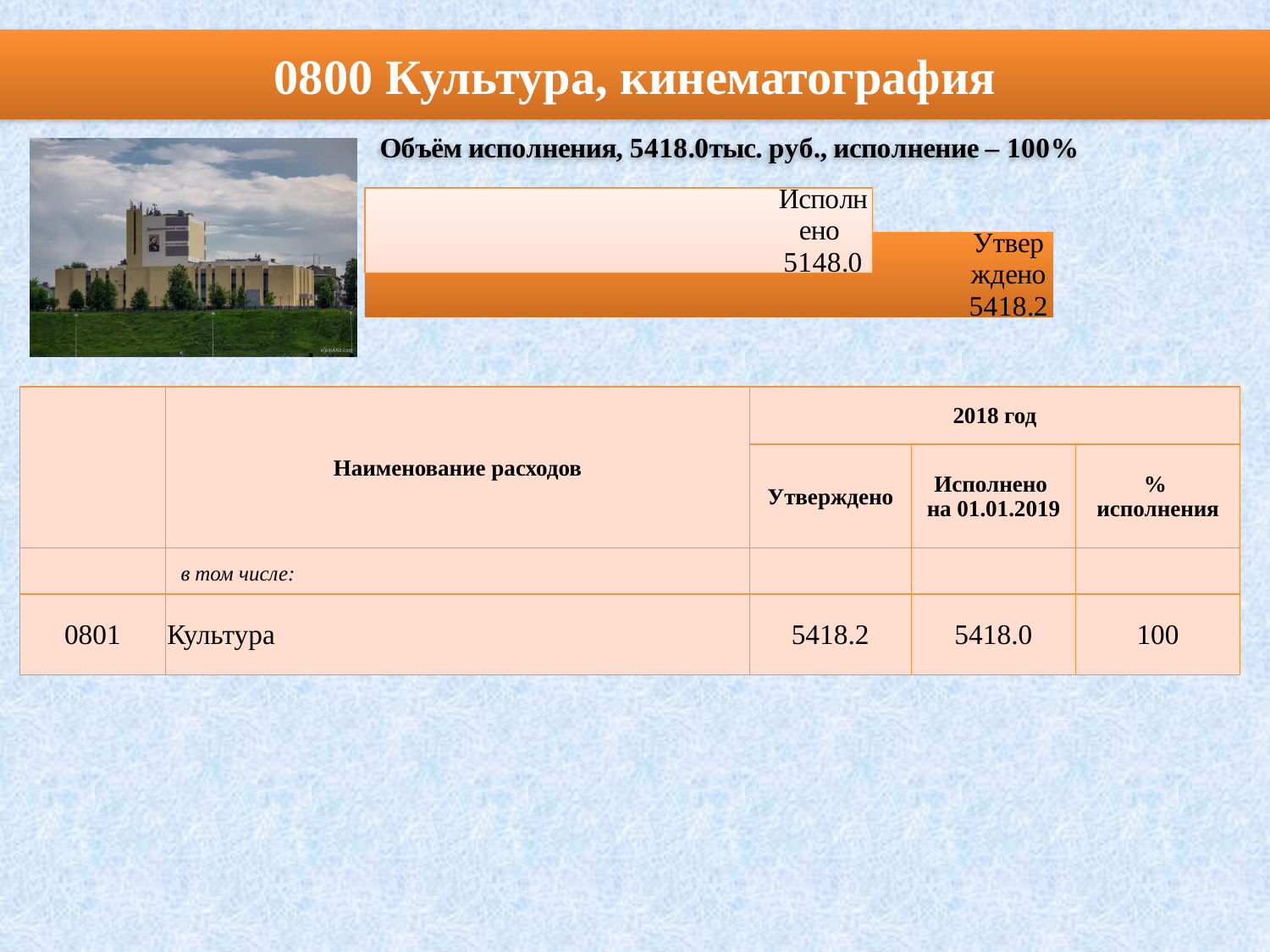
What value is labelled on the Исполнено bar? 5148.0 What value is labelled on the Утверждено bar? 5418.2 Which bar is longer, Утверждено or Исполнено? Утверждено What kind of chart is shown on the slide? bar chart Which bar has the highest labelled value? Утверждено Which bar is positioned above the other in the chart? Исполнено Which bar has the lowest labelled value? Исполнено What colour is the Утверждено bar? orange What is the difference between the labelled values of the Утверждено and Исполнено bars? 270.2 How many bars does the chart show? 2